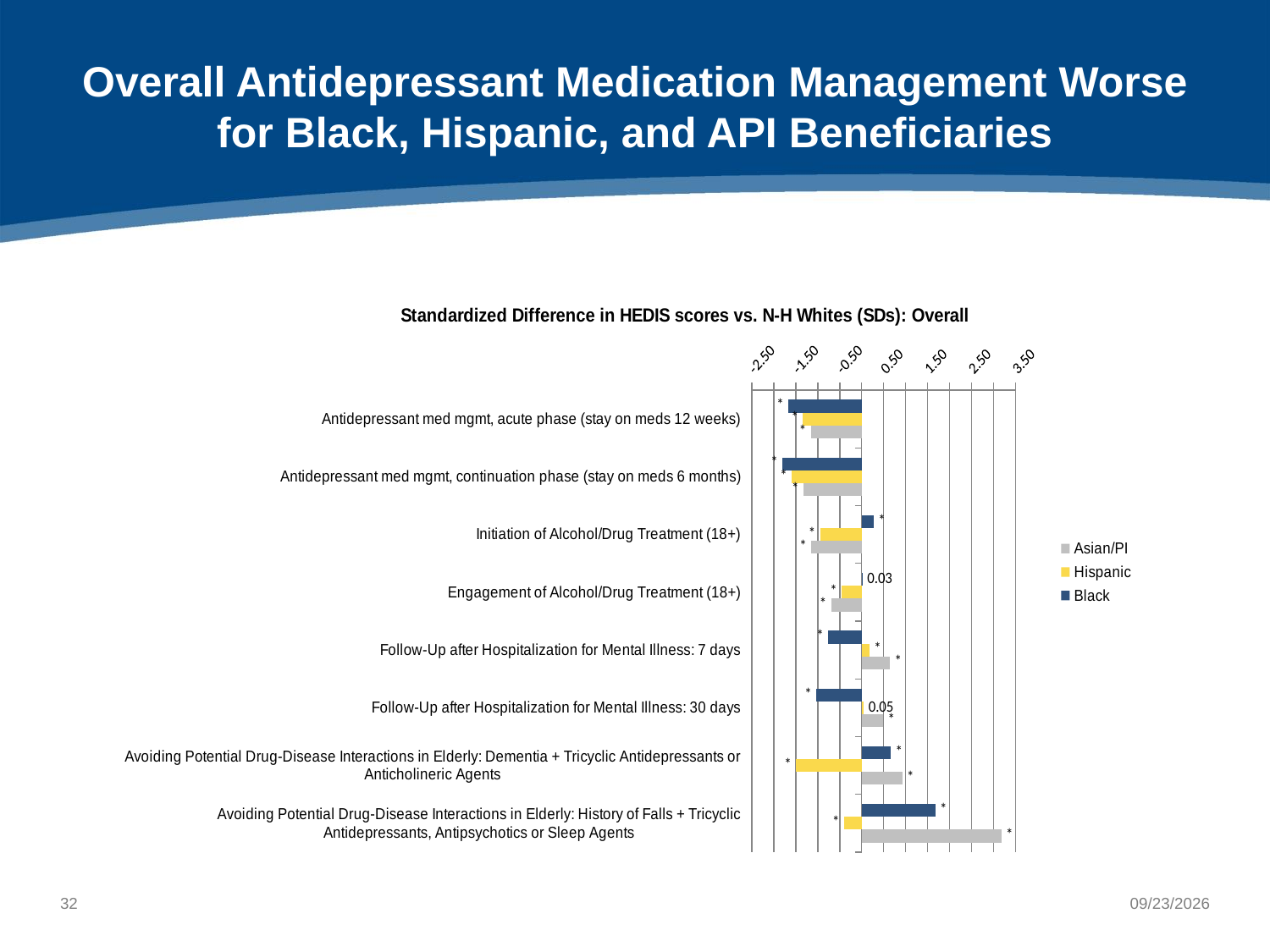
Is the Hispanic value for Avoiding Potential Drug-Disease Interactions in Elderly: Dementia + Tricyclic Antidepressants or Anticholineric Agents greater or less than -0.50? less How many series does the legend list? 3 Which colour represents the Hispanic series in the legend? yellow Which series has the highest value for Avoiding Potential Drug-Disease Interactions in Elderly: History of Falls + Tricyclic Antidepressants, Antipsychotics or Sleep Agents? Asian/PI For Avoiding Potential Drug-Disease Interactions in Elderly: Dementia + Tricyclic Antidepressants or Anticholineric Agents, which is larger, the Black value or the Hispanic value? Black What kind of chart is shown on the slide? bar chart How many measure categories are plotted on the chart? 8 What is the title of the chart? Standardized Difference in HEDIS scores vs. N-H Whites (SDs): Overall What is the Black value for Engagement of Alcohol/Drug Treatment (18+)? 0.03 Is the Asian/PI value for Avoiding Potential Drug-Disease Interactions in Elderly: History of Falls + Tricyclic Antidepressants, Antipsychotics or Sleep Agents greater or less than 2.50? greater Is the Black value for Antidepressant med mgmt, continuation phase (stay on meds 6 months) greater or less than -1.50? less What is the Hispanic value for Follow-Up after Hospitalization for Mental Illness: 30 days? 0.05